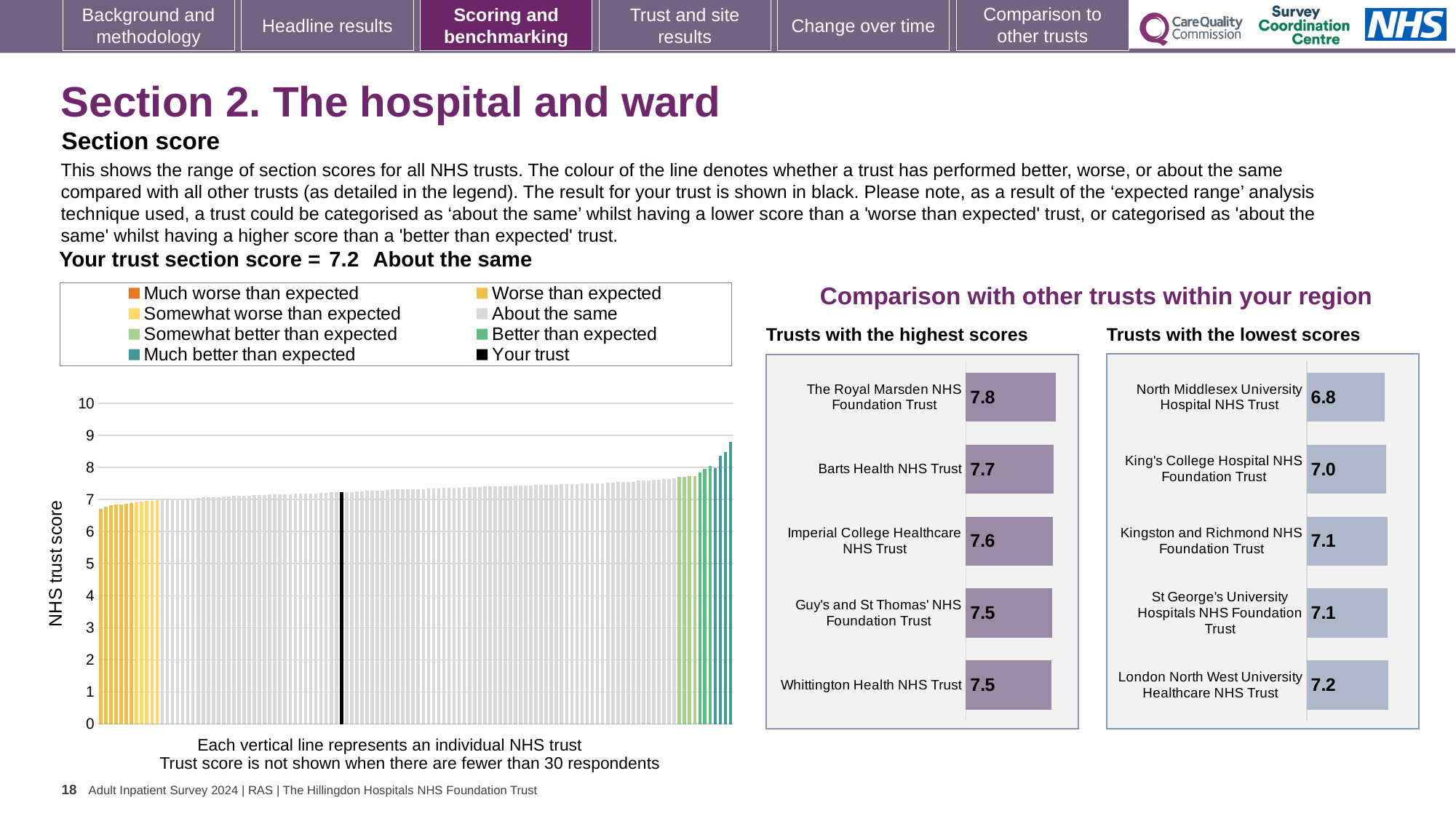
In the 'Trusts with the highest scores' chart, which has the higher score: Imperial College Healthcare NHS Trust or Guy's and St Thomas' NHS Foundation Trust? Imperial College Healthcare NHS Trust In the 'Trusts with the highest scores' chart, what is the difference between the scores of The Royal Marsden NHS Foundation Trust and Barts Health NHS Trust? 0.1 In the 'Trusts with the highest scores' chart, what is the score for The Royal Marsden NHS Foundation Trust? 7.8 In the 'Trusts with the highest scores' chart, what is the score for Whittington Health NHS Trust? 7.5 In the 'Trusts with the lowest scores' chart, how much higher is the score of London North West University Healthcare NHS Trust than that of North Middlesex University Hospital NHS Trust? 0.4 How many entries does the legend above the left-hand chart list? 8 What kind of chart is the large chart on the left showing NHS trust scores? Bar chart In the 'Trusts with the lowest scores' chart, which trust has the lowest score? North Middlesex University Hospital NHS Trust In the 'Trusts with the highest scores' chart, which trust has the highest score? The Royal Marsden NHS Foundation Trust In the left-hand chart of NHS trust scores, do the values rise or fall from left to right? Rise How many trusts are shown in the 'Trusts with the lowest scores' chart? 5 In the 'Trusts with the lowest scores' chart, what is the score for King's College Hospital NHS Foundation Trust? 7.0